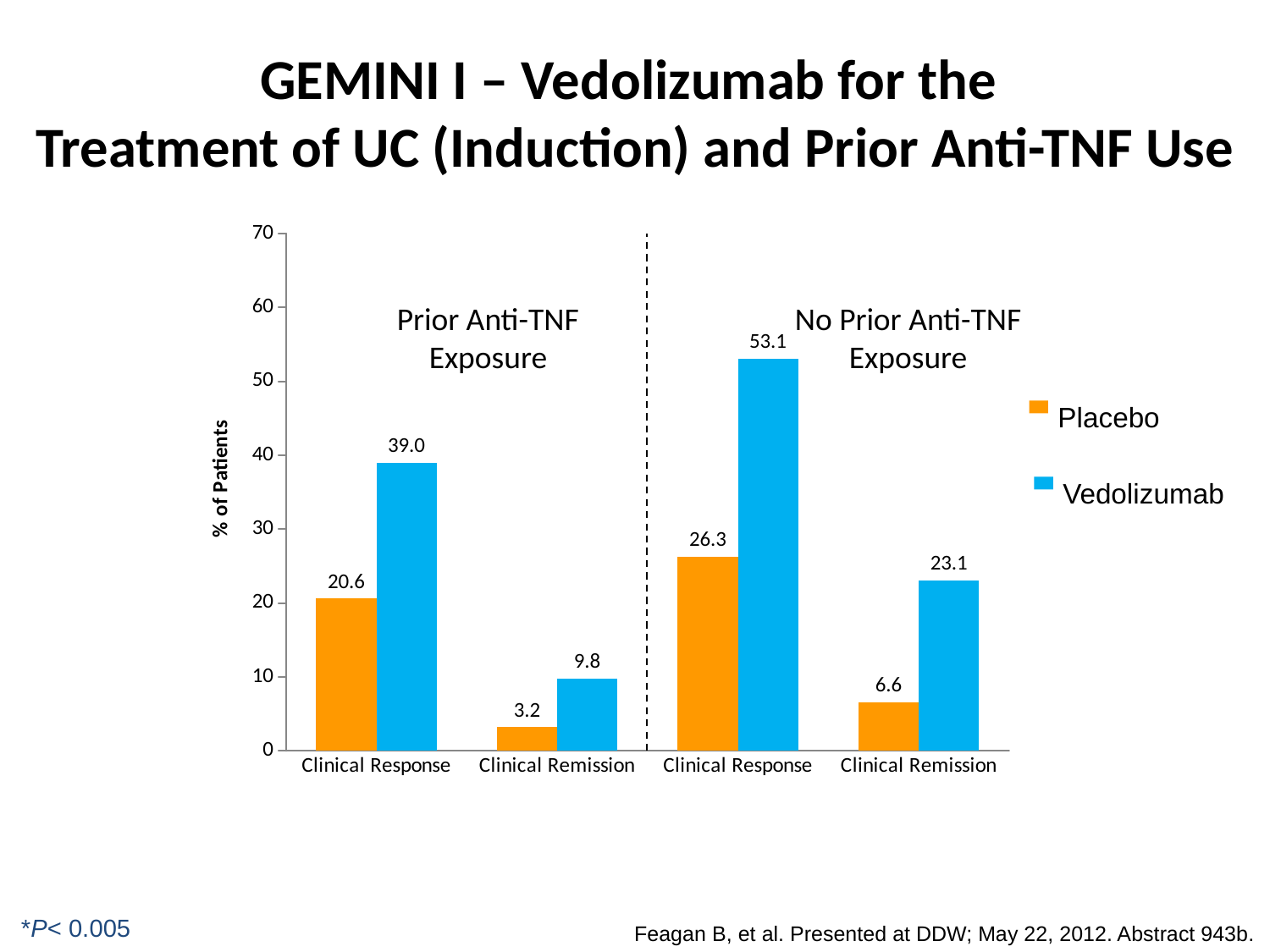
What is the label of the y axis? % of Patients What kind of chart is shown on the slide? Bar chart Is the Vedolizumab value for Clinical Response in the No Prior Anti-TNF Exposure group greater or less than 50? greater What is the difference between the Vedolizumab and Placebo values for Clinical Remission in the Prior Anti-TNF Exposure group? 6.6 What is the Placebo value for Clinical Remission in the No Prior Anti-TNF Exposure group? 6.6 How many series does the legend list? 2 What is the difference between the Vedolizumab and Placebo values for Clinical Response in the No Prior Anti-TNF Exposure group? 26.8 Which bar has the highest value on the chart? Vedolizumab, Clinical Response, No Prior Anti-TNF Exposure What is the Vedolizumab value for Clinical Response in the Prior Anti-TNF Exposure group? 39.0 What is the Placebo value for Clinical Response in the Prior Anti-TNF Exposure group? 20.6 Which is larger: the Vedolizumab value for Clinical Remission with No Prior Anti-TNF Exposure or the Placebo value for Clinical Response with Prior Anti-TNF Exposure? Vedolizumab, Clinical Remission, No Prior Anti-TNF Exposure Which bar has the lowest value on the chart? Placebo, Clinical Remission, Prior Anti-TNF Exposure